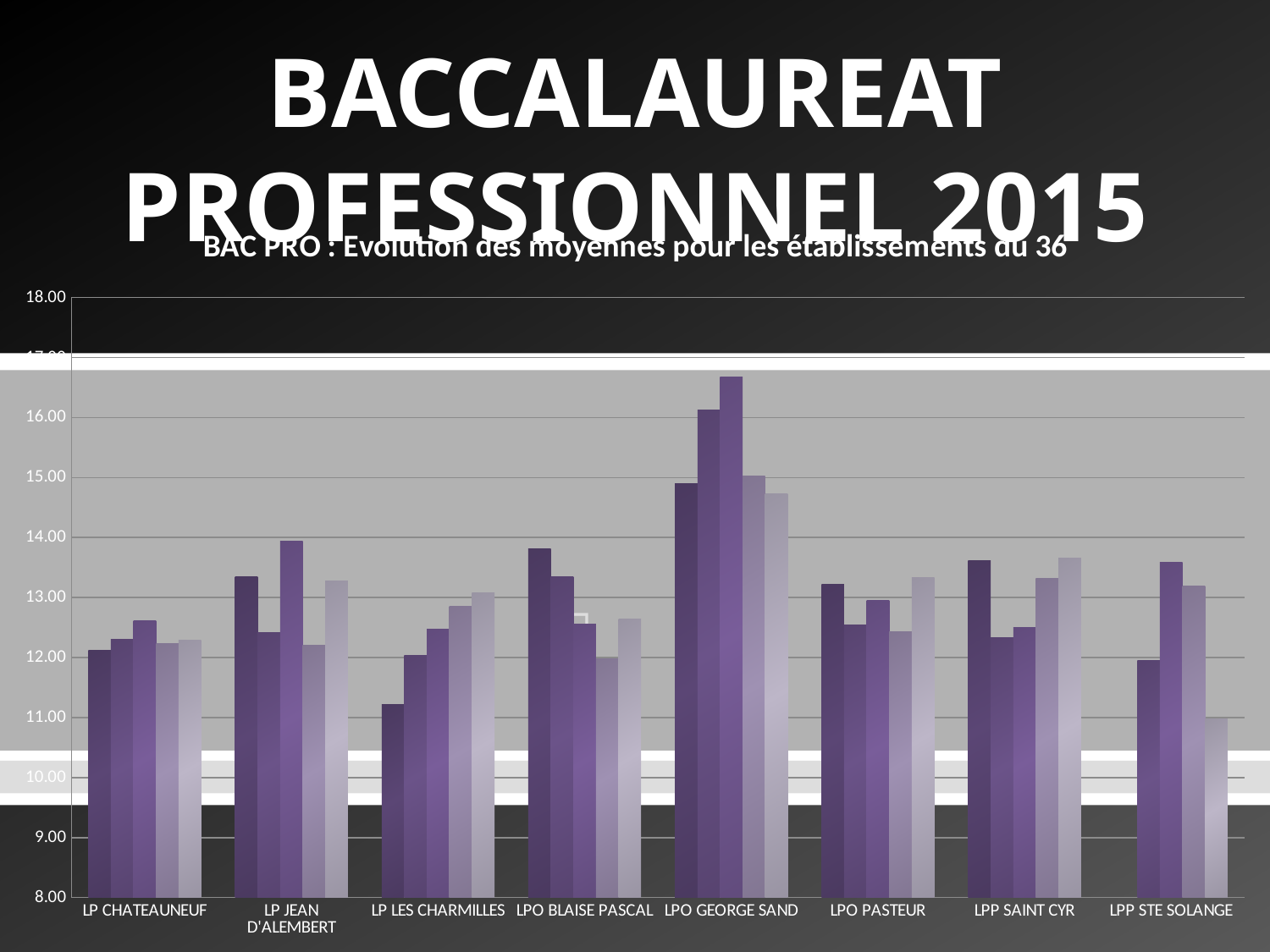
Which has the taller highest bar: LPO GEORGE SAND or LPO PASTEUR? LPO GEORGE SAND Which establishment has the tallest bar in the chart? LPO GEORGE SAND Is the first bar for LP LES CHARMILLES greater or less than 12.00? less Is the first bar for LPO GEORGE SAND greater or less than 14.00? greater Is the tallest bar for LPO GEORGE SAND greater or less than 16.00? greater What is the maximum value shown on the chart's vertical axis? 18.00 How many establishments (categories) are shown on the x axis of the chart? 8 What kind of chart is shown on the slide? bar chart What is the title of the chart? BAC PRO : Evolution des moyennes pour les établissements du 36 How many bars are plotted for each establishment in the chart? 5